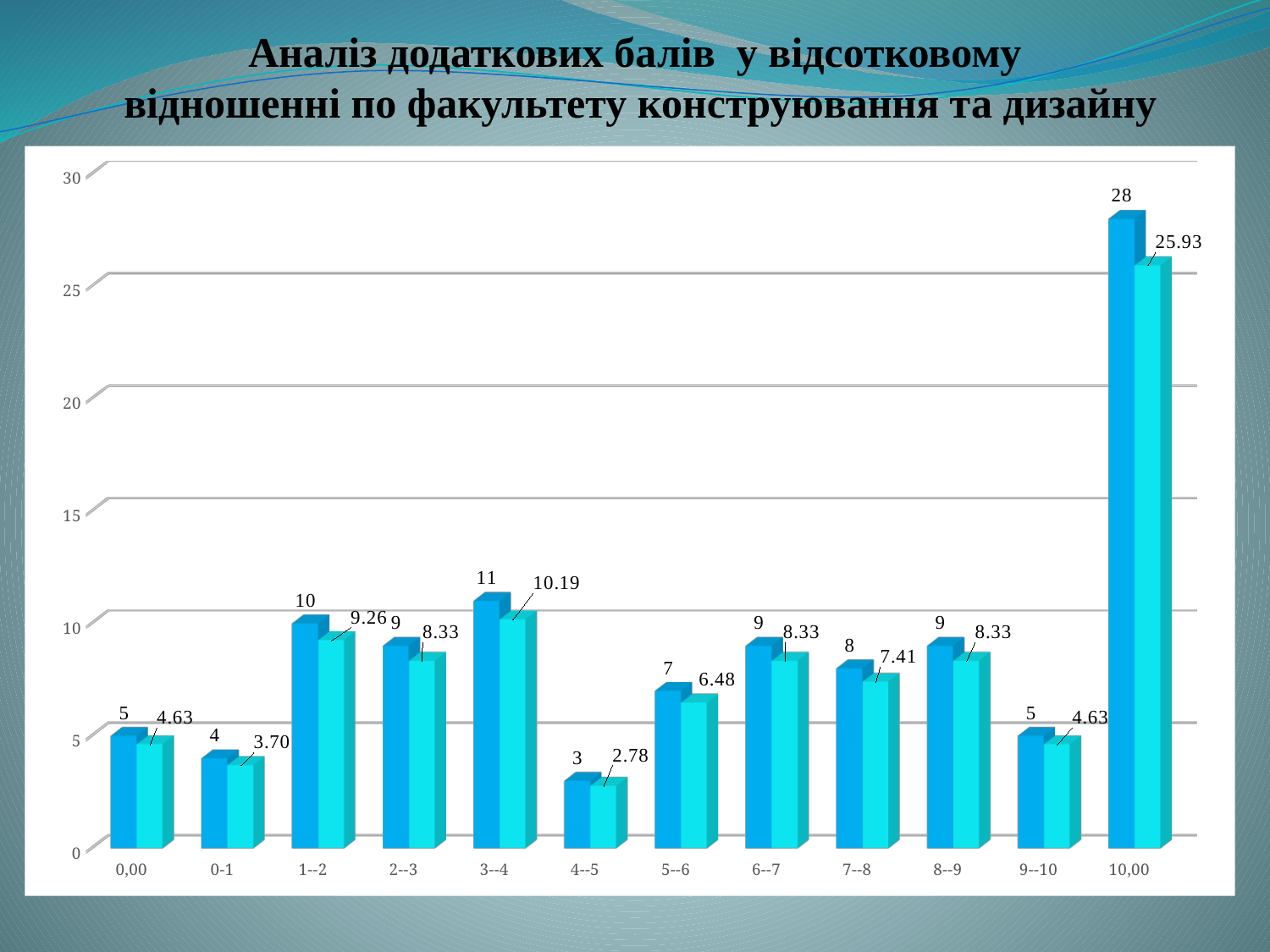
Which is larger: the dark blue bar for 1--2 or the dark blue bar for 2--3? 1--2 What is the value of the dark blue bar for the category 5--6? 7 What is the value of the light blue bar for the category 0-1? 3.70 What is the title of the chart on the slide? Аналіз додаткових балів у відсотковому відношенні по факультету конструювання та дизайну What kind of chart is shown on the slide? bar chart How many categories are shown on the x axis? 12 Which category has the lowest light blue bar? 4--5 What is the value of the dark blue bar for the category 10,00? 28 Which category has the highest dark blue bar? 10,00 Is the light blue bar for 10,00 greater or less than 25? greater What is the difference between the dark blue bar values for 10,00 and 3--4? 17 What is the value of the light blue bar for the category 3--4? 10.19